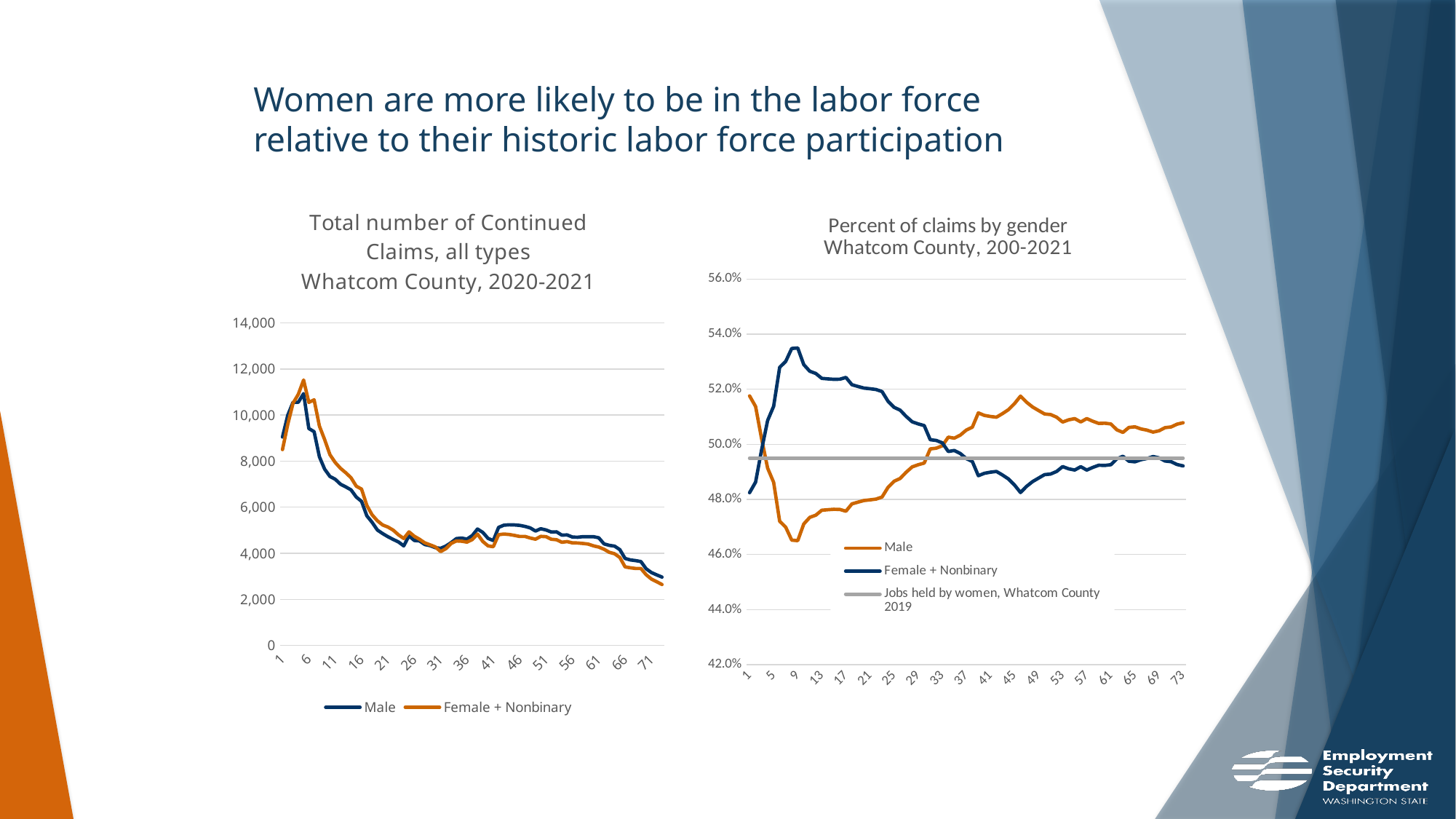
In the left chart, 'Total number of Continued Claims, all types', is the peak value for Female + Nonbinary greater or less than 10,000? greater What kind of chart is the left chart, 'Total number of Continued Claims, all types'? line chart In the right chart, 'Percent of claims by gender', which series is higher at point 9, Male or Female + Nonbinary? Female + Nonbinary In the right chart, 'Percent of claims by gender', which series is higher at point 45, Male or Female + Nonbinary? Male How many entries does the legend of the right chart, 'Percent of claims by gender', list? 3 In the left chart, 'Total number of Continued Claims, all types', is the value for Male at point 71 greater or less than 4,000? less In the left chart, 'Total number of Continued Claims, all types', do the values for Male generally rise or fall from point 6 to point 71? fall In the right chart, 'Percent of claims by gender', is the lowest value for Male greater or less than 48.0%? less In the right chart, 'Percent of claims by gender', do the values for Female + Nonbinary rise or fall from point 9 to point 45? fall In the right chart, 'Percent of claims by gender', what does the gray horizontal line represent according to the legend? Jobs held by women, Whatcom County 2019 How many series does the legend of the left chart, 'Total number of Continued Claims, all types', list? 2